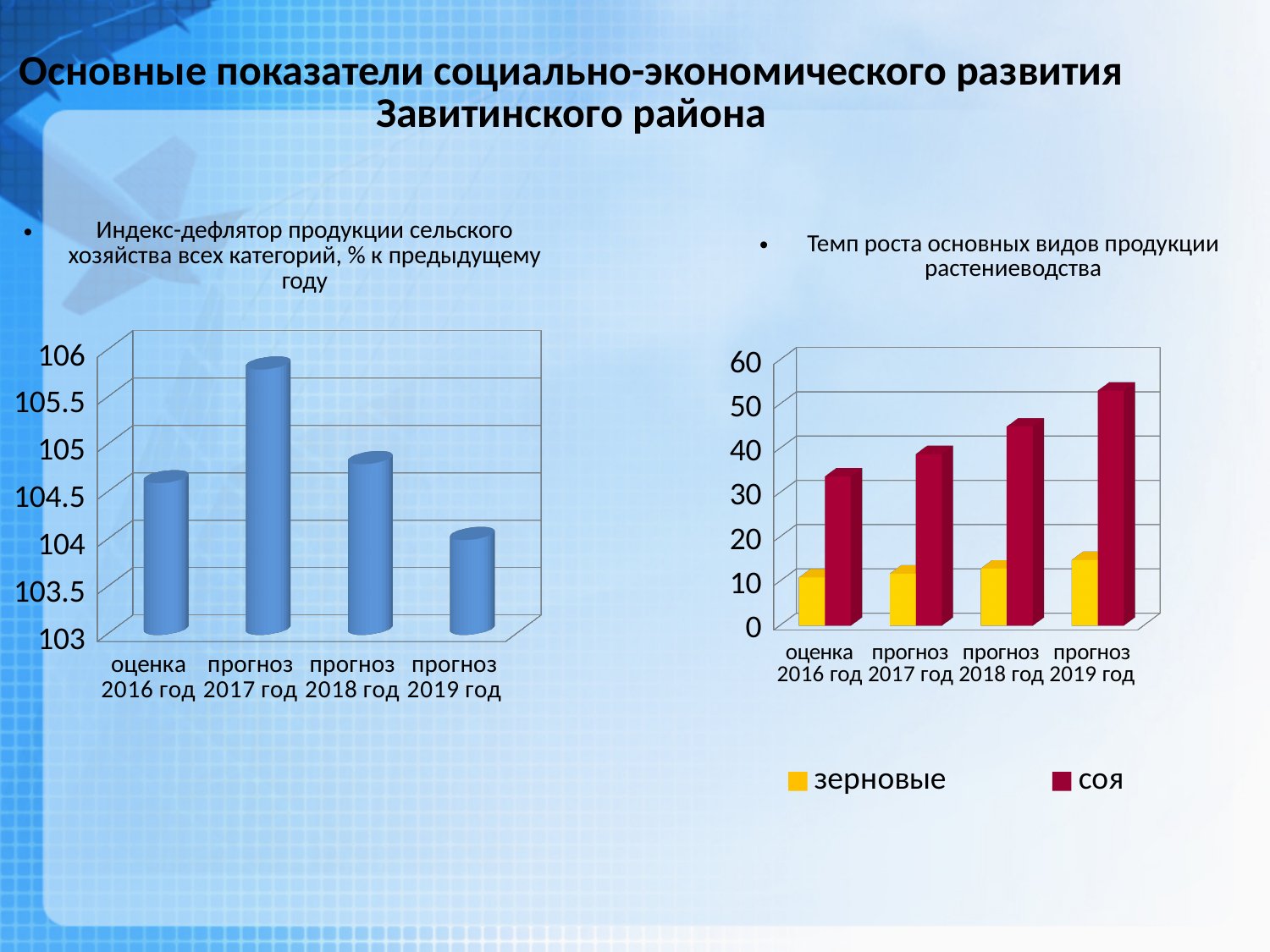
How many series does the legend of the right chart, 'Темп роста основных видов продукции растениеводства', list? 2 In the right chart (Темп роста), do the values for соя rise or fall from 2016 to 2019? rise How many categories are shown on the x axis of the left chart (Индекс-дефлятор)? 4 In the right chart (Темп роста), which is larger in прогноз 2018 год: зерновые or соя? соя In the left chart (Индекс-дефлятор), is the value for прогноз 2018 год greater or less than 105? less In the left chart (Индекс-дефлятор), which year has the highest value? прогноз 2017 год In the right chart (Темп роста), which year has the highest value for соя? прогноз 2019 год In the left chart (Индекс-дефлятор), is the value for прогноз 2017 год greater or less than 105.5? greater What kind of chart is the left chart, 'Индекс-дефлятор продукции сельского хозяйства всех категорий, % к предыдущему году'? bar chart In the right chart (Темп роста), which colour represents зерновые in the legend? yellow In the right chart (Темп роста), is the value for соя in прогноз 2019 год greater or less than 50? greater In the left chart (Индекс-дефлятор), which year has the lowest value? прогноз 2019 год